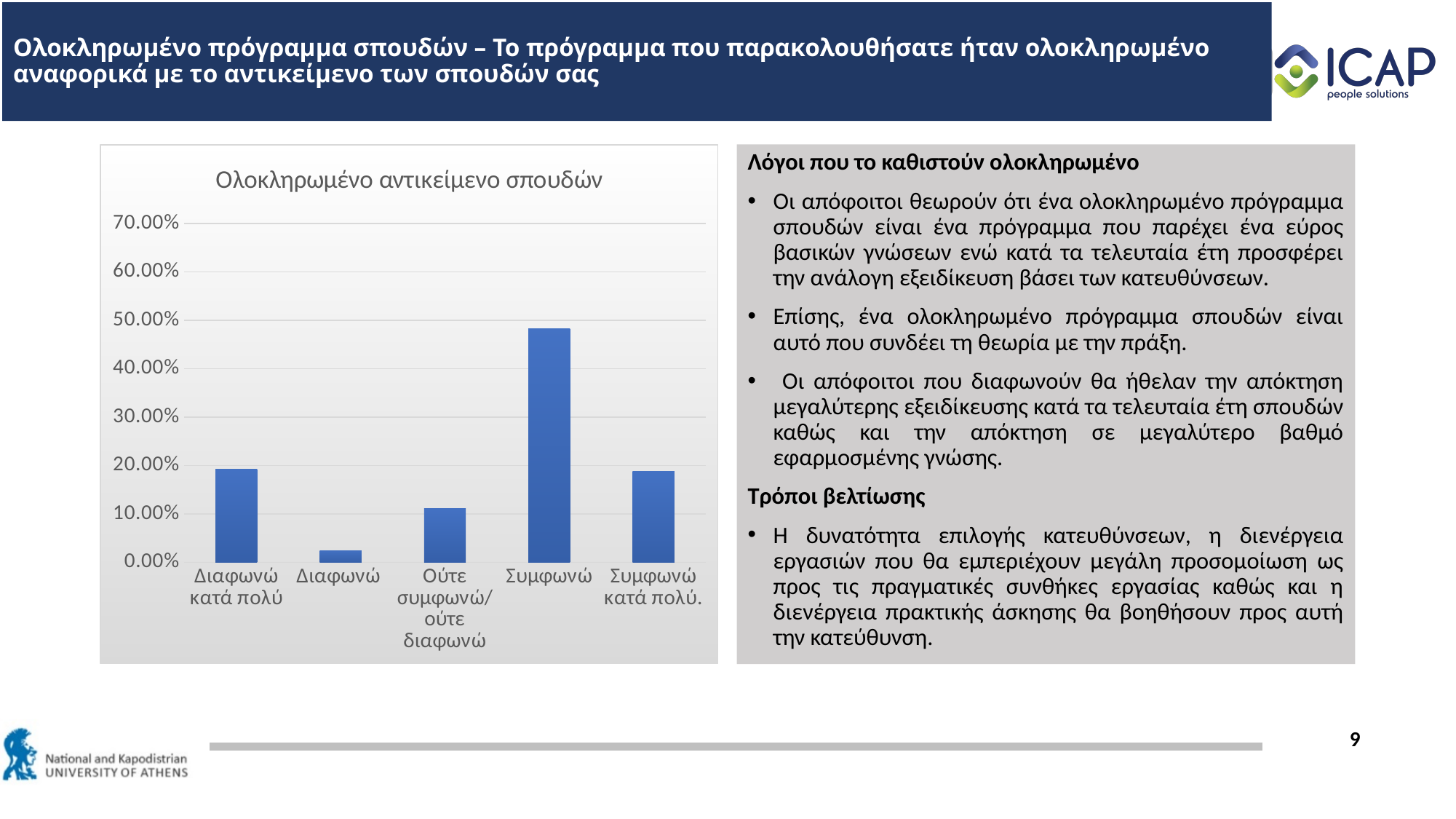
What is the highest value shown on the y axis of the chart? 70.00% What type of chart is shown on the slide? bar chart Is the value for Ούτε συμφωνώ/ούτε διαφωνώ greater or less than 20.00%? less Which is larger, the value for Συμφωνώ or the value for Ούτε συμφωνώ/ούτε διαφωνώ? Συμφωνώ Which category has the lowest value in the chart? Διαφωνώ Is the value for Συμφωνώ greater or less than 50.00%? less Which category has the highest value in the chart? Συμφωνώ Is the value for Διαφωνώ κατά πολύ greater or less than 10.00%? greater What is the title of the chart? Ολοκληρωμένο αντικείμενο σπουδών How many categories are shown on the x axis of the chart? 5